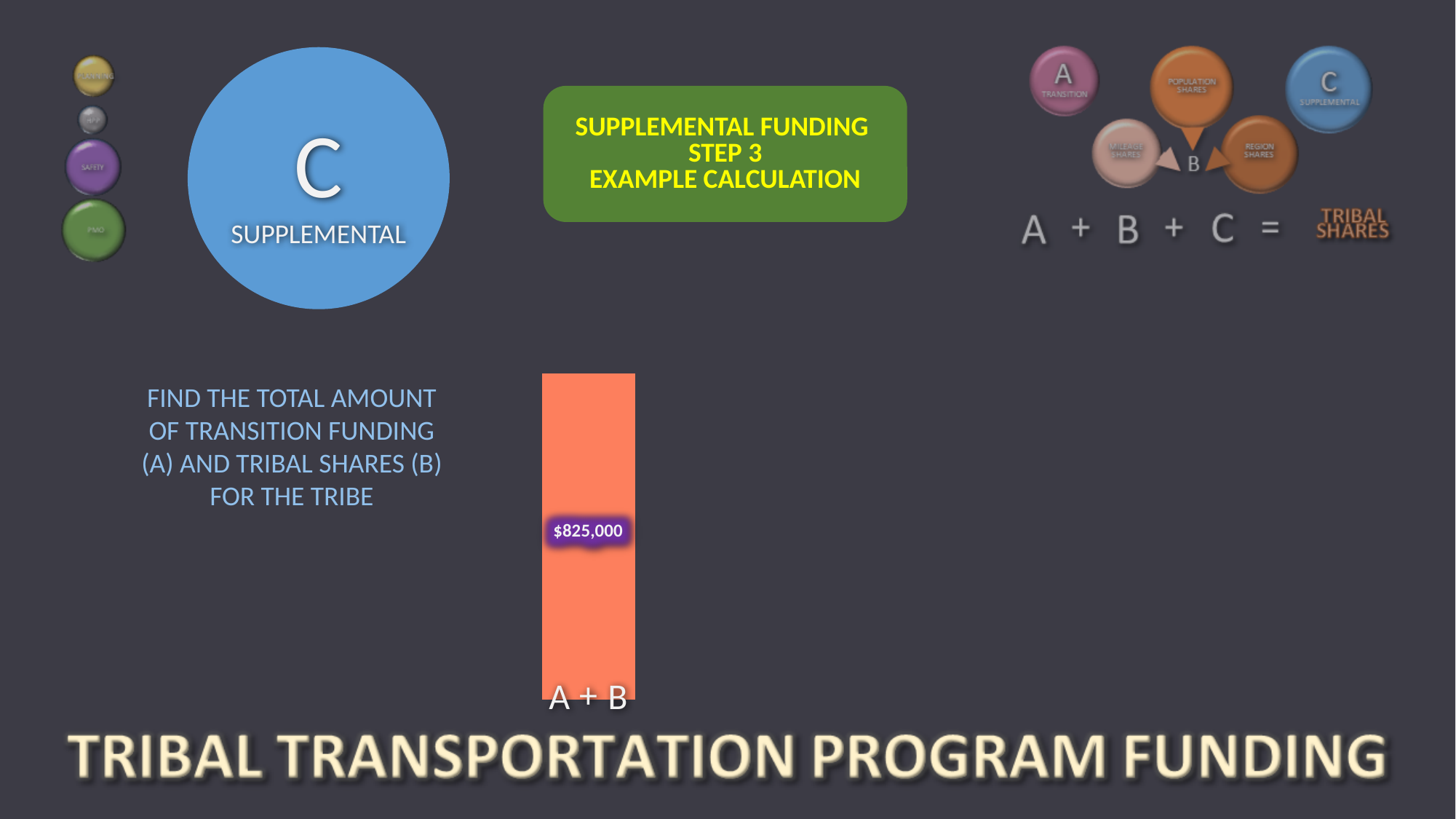
What is the category label under the bar? A + B How many bars does the chart show? 1 What kind of chart is shown on the slide? bar chart What colour is the A + B bar? orange What is the value shown for the A + B bar? $825,000